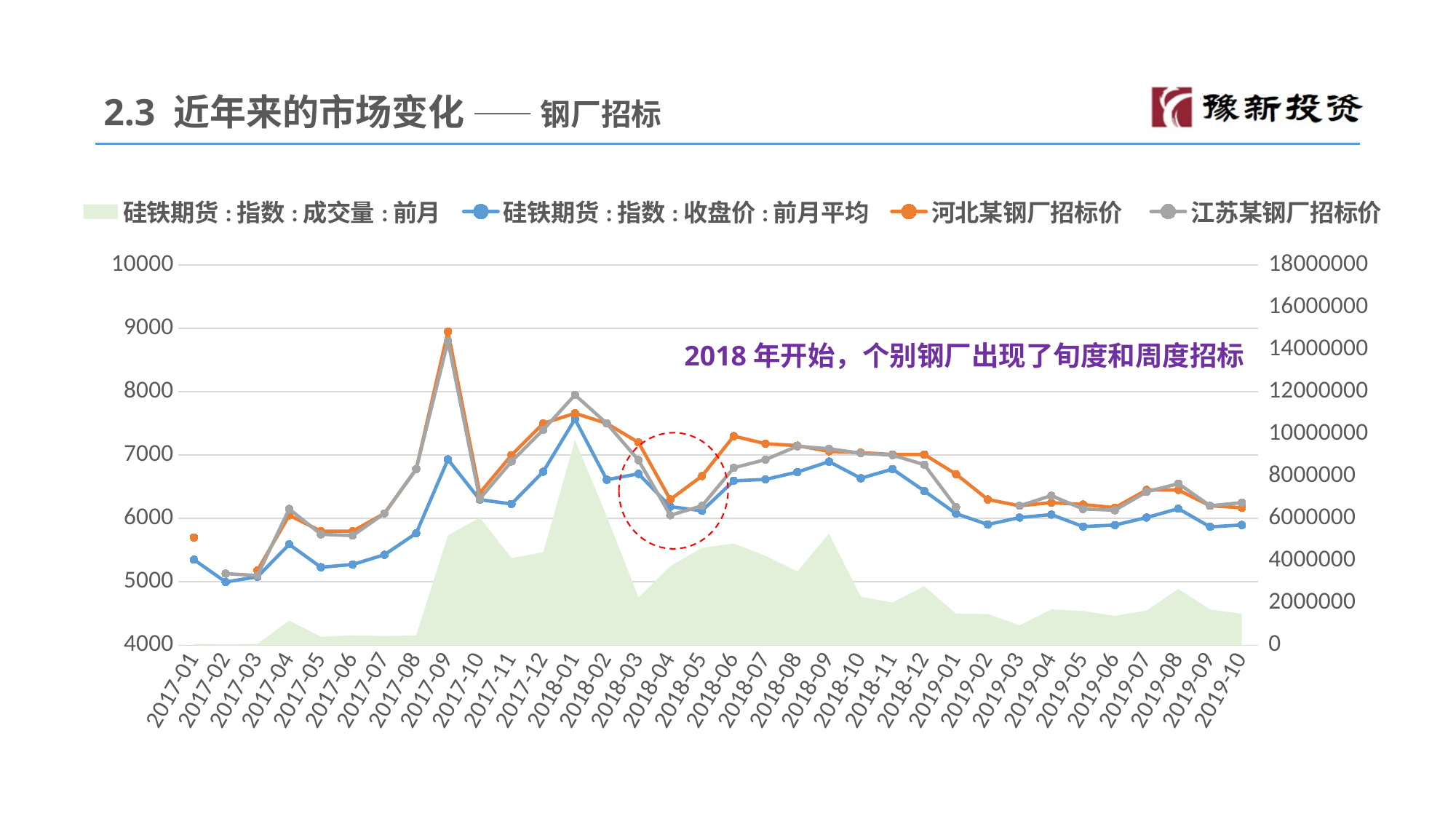
What kind of chart is this? Combination line and area chart In which month does 硅铁期货:指数:收盘价:前月平均 reach its highest value? 2018-01 How many series does the legend list? 4 Does 河北某钢厂招标价 rise or fall from 2018-06 to 2019-06? fall How many months are shown on the x axis? 34 In 2017-09, which is larger: 河北某钢厂招标价 or 硅铁期货:指数:收盘价:前月平均? 河北某钢厂招标价 In which month does 江苏某钢厂招标价 reach its highest value? 2017-09 In which month does 河北某钢厂招标价 reach its highest value? 2017-09 What is the highest tick value shown on the right-hand axis? 18000000 Is the value for 硅铁期货:指数:收盘价:前月平均 in 2017-02 greater or less than 6000? less Is the value for 河北某钢厂招标价 in 2017-09 greater or less than 8000? greater